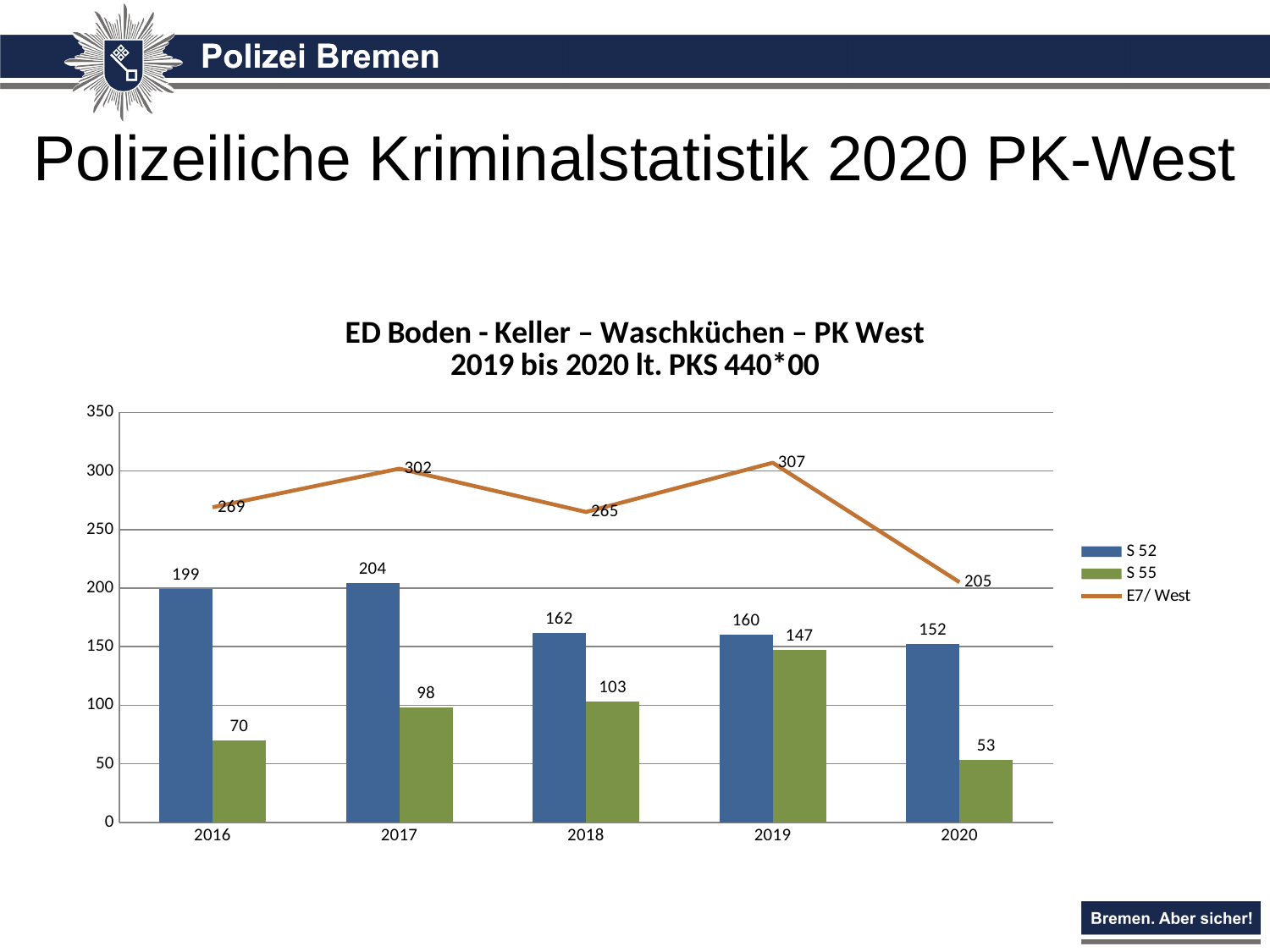
Which is larger in 2018: S 52 or S 55? S 52 What is the difference between S 52 and S 55 in 2020? 99 How many years are shown on the x axis? 5 How many series does the legend list? 3 What is the value of S 55 in 2019? 147 Does the S 52 series rise or fall from 2017 to 2020? fall What is the value of S 52 in 2016? 199 In which year is the E7/ West line at its highest? 2019 Is the value of E7/ West in 2017 greater or less than 300? greater In which year is S 55 at its lowest? 2020 What is the value of E7/ West in 2020? 205 What kind of chart is this? Combined bar and line chart